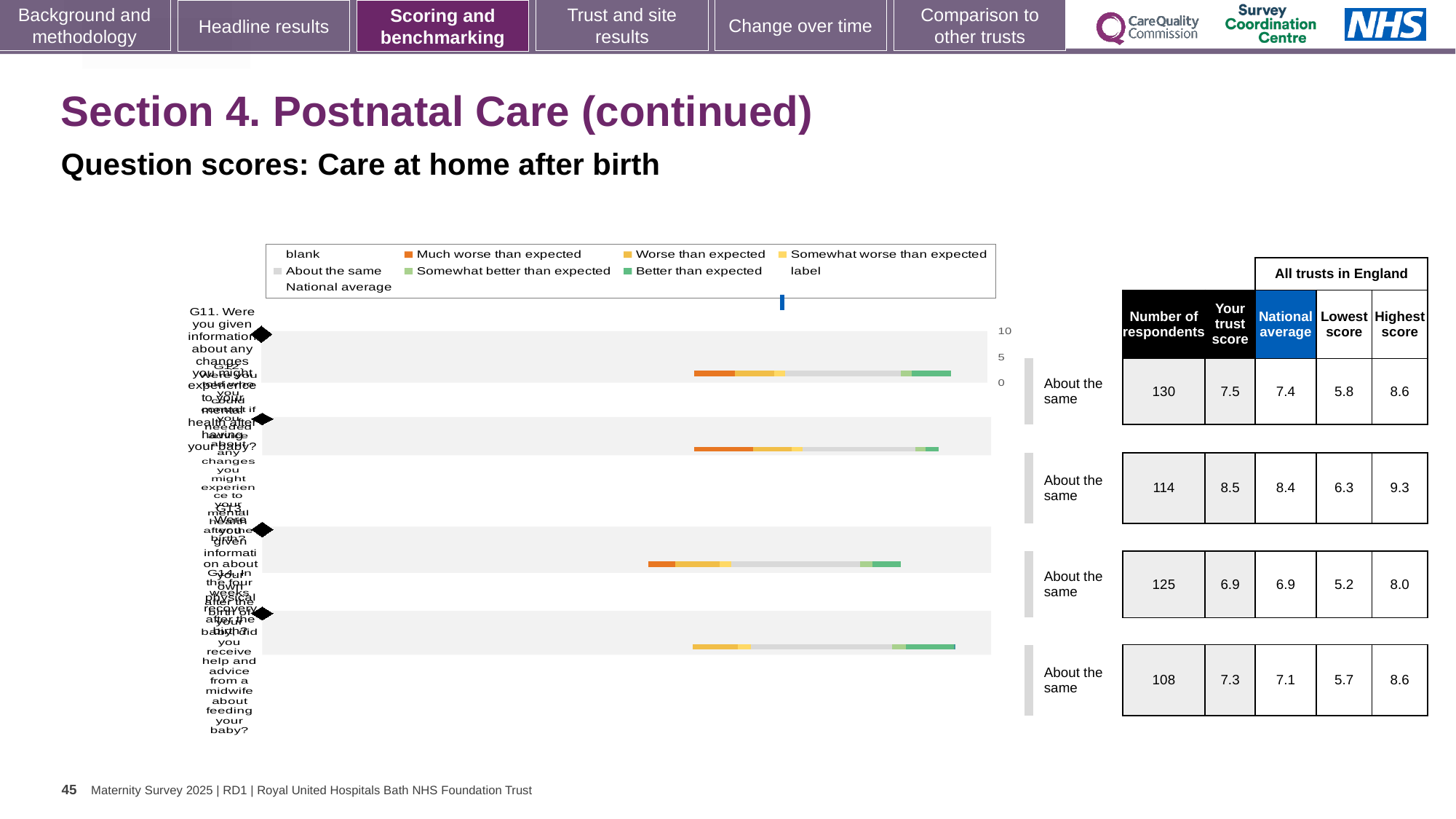
What is the first legend entry shown in orange in the chart legend? Much worse than expected In the table next to the chart, is the 'Your trust score' in the third row larger or smaller than the 'National average' in that row? equal (both 6.9) In the table next to the chart, which row has the highest 'Your trust score'? the second row (8.5) What benchmark category is shown for every row next to the chart? About the same In the table next to the chart, what is the difference between the 'Your trust score' and the 'National average' in the fourth row? 0.2 In the table next to the chart, what is the 'Your trust score' for the second row? 8.5 What kind of chart is shown on the slide? bar chart How many bars (question rows) does the chart show? 4 In the table next to the chart, what is the 'Highest score' for the second row? 9.3 Which legend entry is shown in the darkest green in the chart legend? Better than expected In the table next to the chart, what is the lowest 'Lowest score' value across all rows? 5.2 In the table next to the chart, what is the number of respondents for the first row? 130